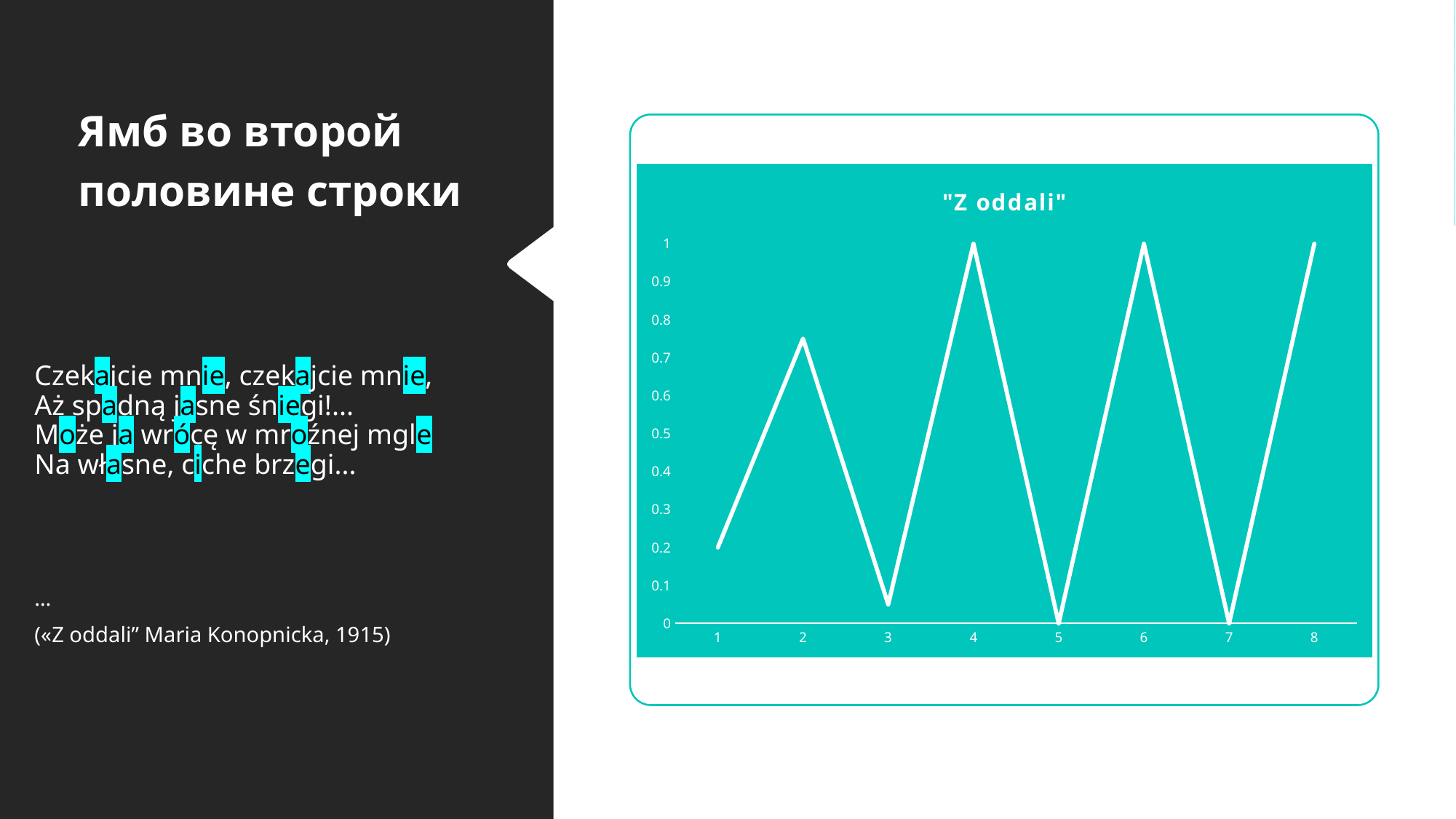
What kind of chart is shown on the slide? line chart Is the value at point 2 greater or less than 0.5? greater How many points are plotted along the x axis of the chart? 8 What is the title of the chart? "Z oddali" What is the value at point 5 on the chart? 0 Does the line rise or fall from point 1 to point 2? rise Is the value at point 3 greater or less than 0.2? less What is the value at point 4 on the chart? 1 What is the value at point 8 on the chart? 1 What is the value at point 1 on the chart? 0.2 What is the difference between the values at point 4 and point 5? 1 Which has the larger value, point 2 or point 3? point 2